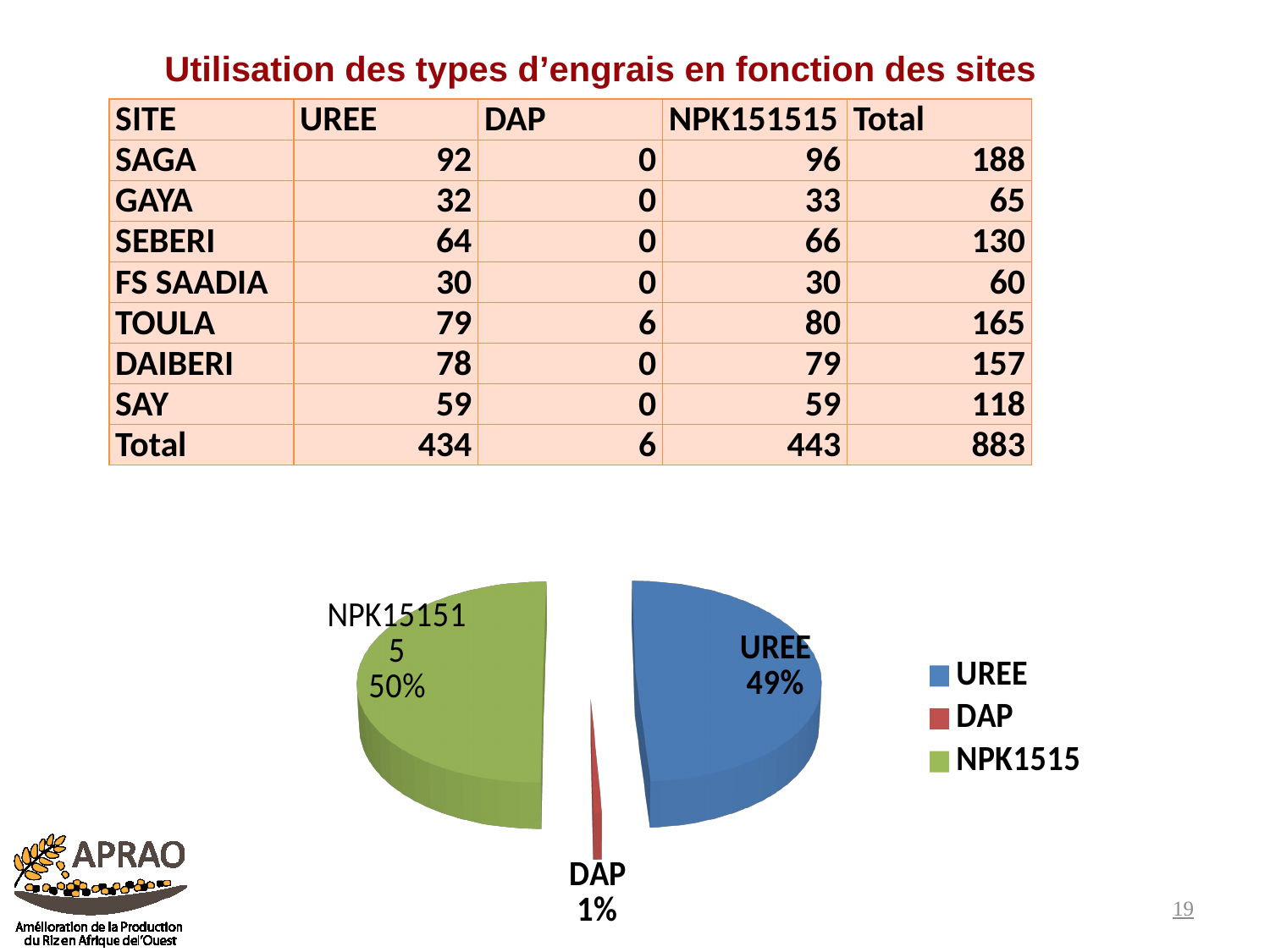
What share of the pie chart does DAP represent? 1% In the pie chart, what is the difference between the UREE share and the DAP share? 48% Which slice of the pie chart is the largest? NPK151515 In the pie chart, which is larger, the UREE share or the DAP share? UREE What colour is the UREE slice in the pie chart? blue What share of the pie chart does NPK151515 represent? 50% How many entries does the pie chart's legend list? 3 What share of the pie chart does UREE represent? 49% How many slices does the pie chart have? 3 What kind of chart is shown on the slide? pie chart In the pie chart, what is the difference between the NPK151515 share and the UREE share? 1% Which slice of the pie chart is the smallest? DAP